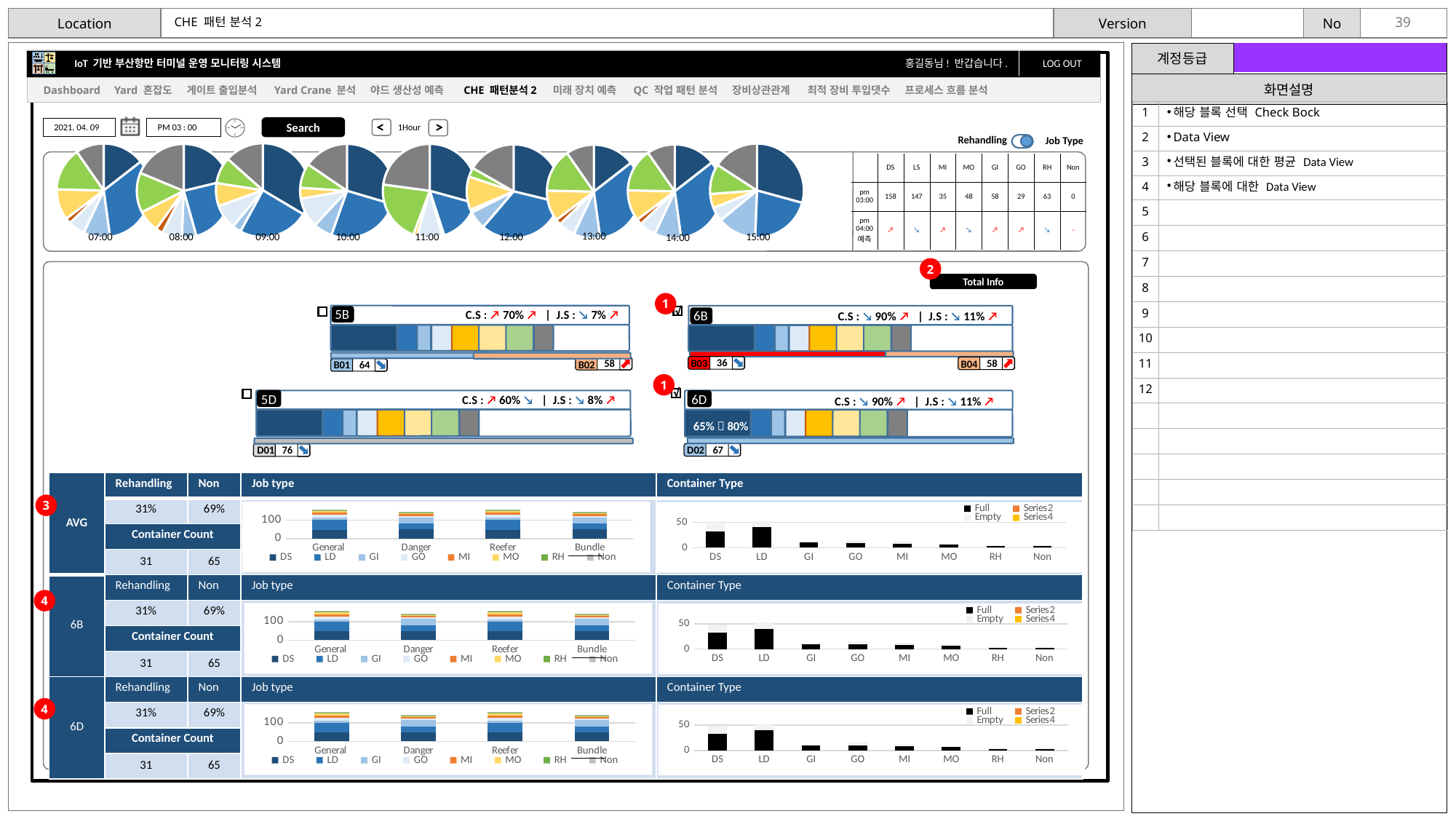
How many pie charts are shown in the row of hourly pies at the top of the screen? 9 What is the time label under the first pie chart in the top row? 07:00 In the AVG row's Container Type chart, which category has the tallest bar? LD What kind of chart is the Job type chart in the AVG row? Stacked bar chart How many categories are shown on the x axis of the AVG row's Container Type chart? 8 What is the first legend entry of the Container Type chart in the AVG row? Full How many series does the legend of the 6B row's Job type chart list? 8 In the 6D row's Container Type chart, which is larger, the bar for DS or the bar for GI? DS How many entries does the legend of the 6D row's Container Type chart list? 4 How many categories are shown on the x axis of the AVG row's Job type chart? 4